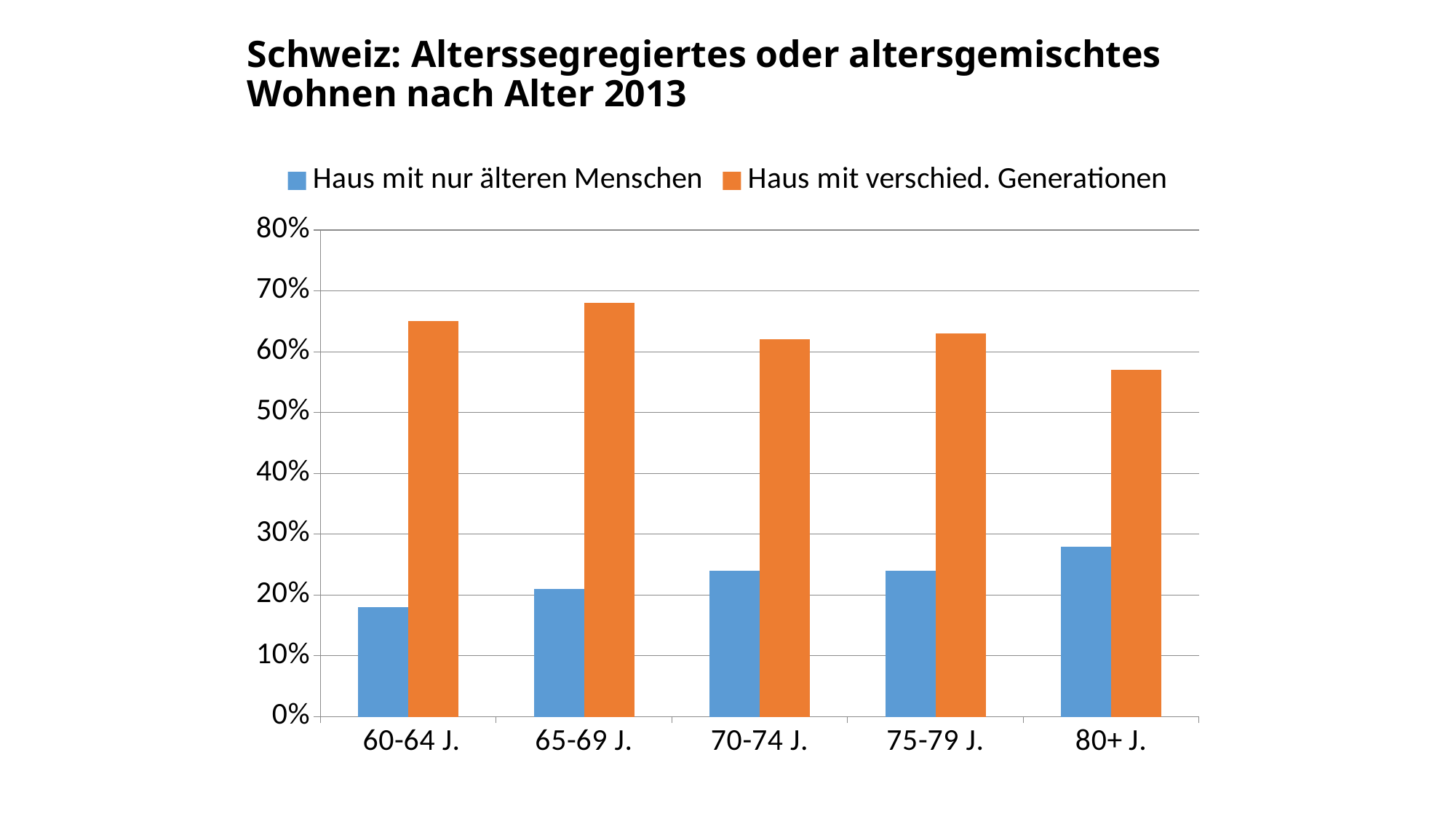
How many series does the legend list? 2 Which age group has the highest value for 'Haus mit nur älteren Menschen'? 80+ J. Which age group has the lowest value for 'Haus mit nur älteren Menschen'? 60-64 J. In the 70-74 J. group, which series has the larger value: 'Haus mit nur älteren Menschen' or 'Haus mit verschied. Generationen'? Haus mit verschied. Generationen Is the value for 'Haus mit verschied. Generationen' in the 80+ J. group greater or less than 60%? less Which age group has the highest value for 'Haus mit verschied. Generationen'? 65-69 J. Which age group has the lowest value for 'Haus mit verschied. Generationen'? 80+ J. What kind of chart is shown on the slide? bar chart Do the values for 'Haus mit nur älteren Menschen' generally rise or fall from the 60-64 J. group to the 80+ J. group? rise How many age groups are shown on the x axis? 5 Is the value for 'Haus mit verschied. Generationen' in the 65-69 J. group greater or less than 60%? greater Is the value for 'Haus mit nur älteren Menschen' in the 60-64 J. group greater or less than 20%? less